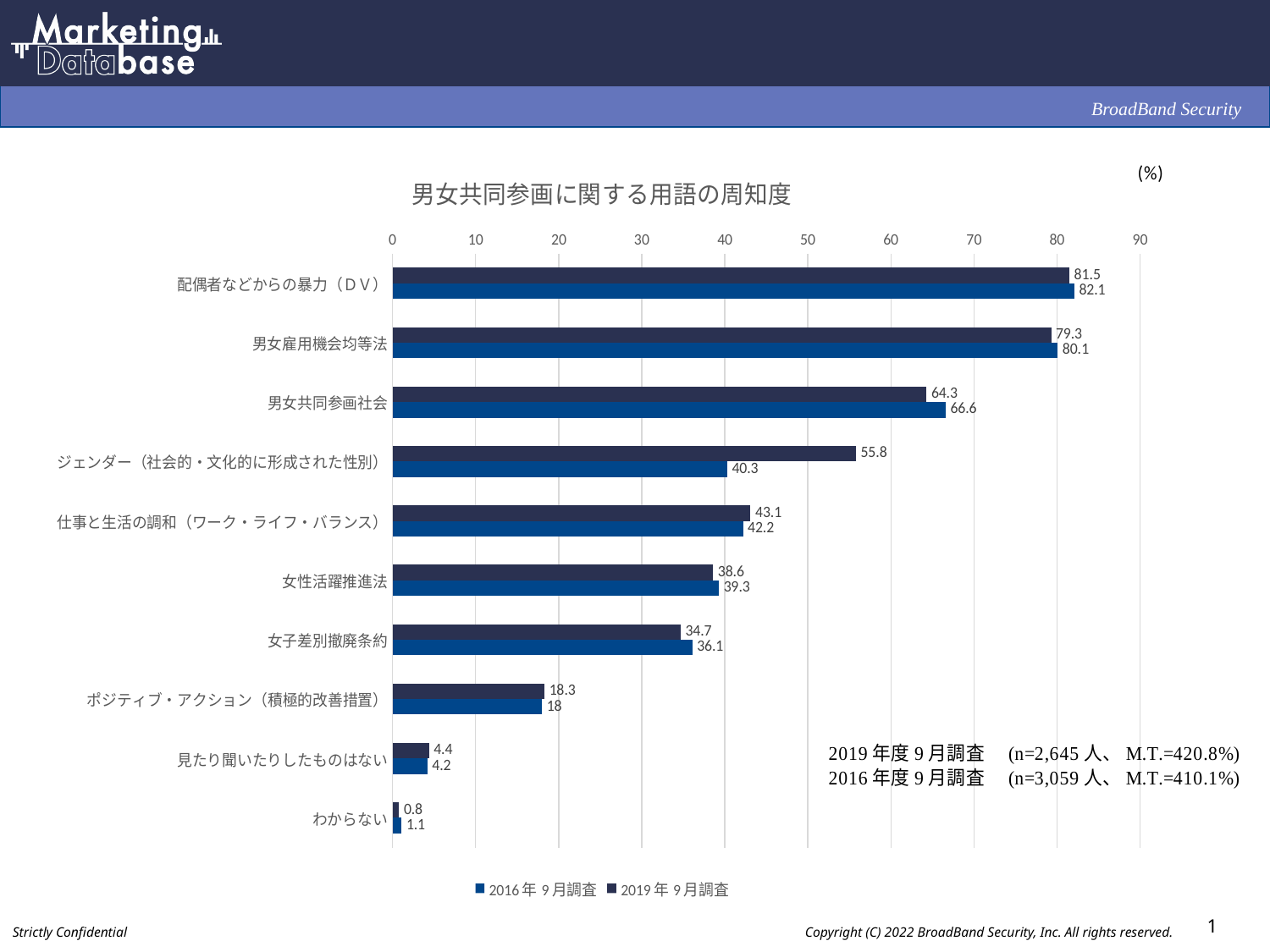
How many series does the legend list? 2 What is the difference between the 2019年 9月調査 and 2016年 9月調査 values for ジェンダー（社会的・文化的に形成された性別）? 15.5 How many categories are shown on the chart? 10 For 女子差別撤廃条約, which series has the larger value, 2016年 9月調査 or 2019年 9月調査? 2016年 9月調査 What is the value for ジェンダー（社会的・文化的に形成された性別） in the 2019年 9月調査 series? 55.8 Which category has the highest value in the 2016年 9月調査 series? 配偶者などからの暴力（ＤＶ） What type of chart is shown on the slide? bar chart What is the title of the chart? 男女共同参画に関する用語の周知度 What is the value for ポジティブ・アクション（積極的改善措置） in the 2016年 9月調査 series? 18 What is the value for 男女共同参画社会 in the 2016年 9月調査 series? 66.6 Which category has the lowest value in the 2019年 9月調査 series? わからない What is the value for 配偶者などからの暴力（ＤＶ） in the 2019年 9月調査 series? 81.5